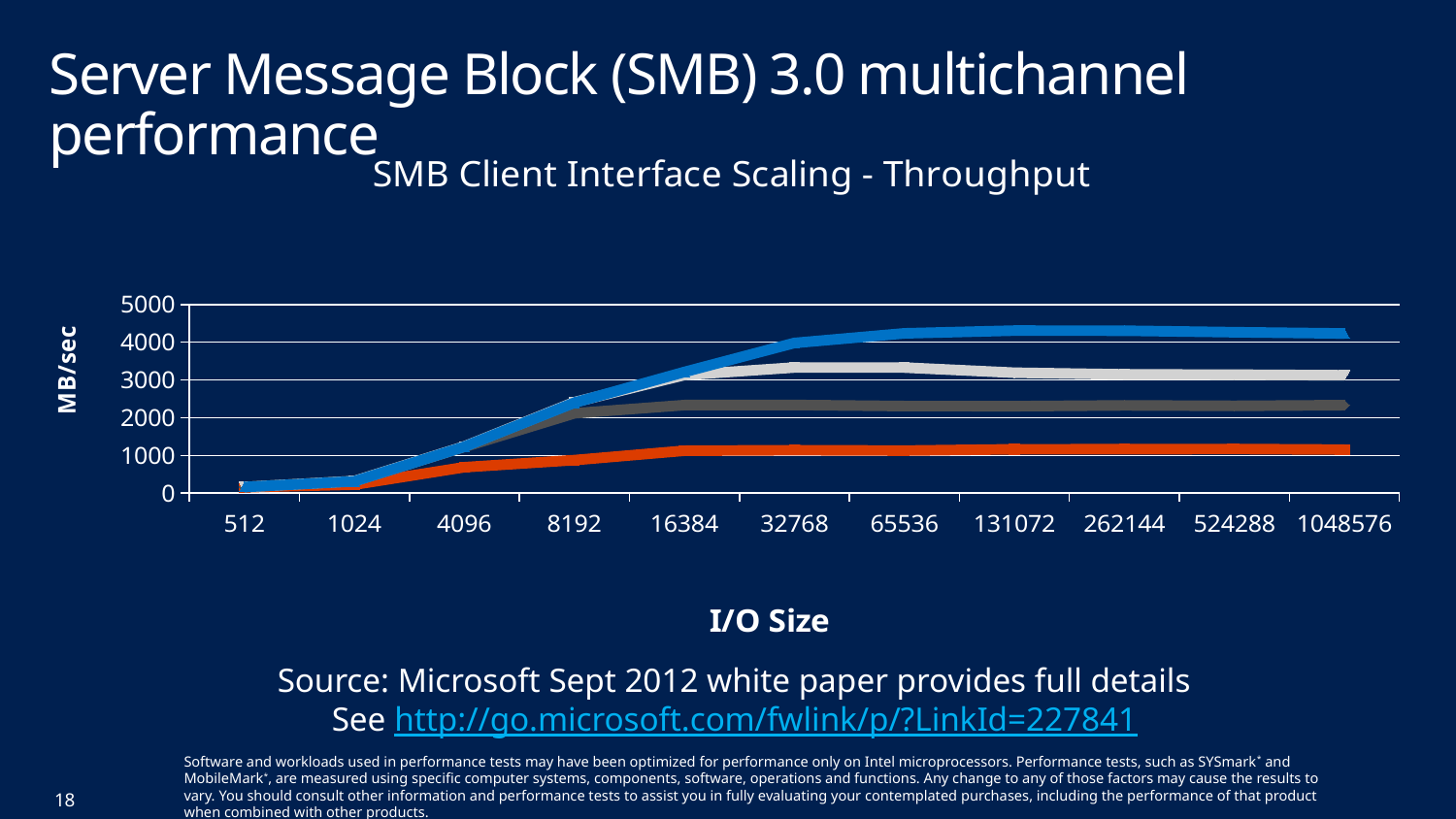
How many I/O size categories are shown on the x axis? 11 Is the value of the orange line at 1048576 greater or less than 2000? less Is the value of the blue line at 1048576 greater or less than 4000? greater Does the blue line rise or fall from 512 to 32768? rise What is the title of the chart? SMB Client Interface Scaling - Throughput How many lines are plotted on the chart? 4 What is the label on the vertical axis of the chart? MB/sec Is the value of the dark gray line at 262144 greater or less than 2000? greater What kind of chart is shown on the slide? line chart Which line has the highest value at 1048576? the blue line At 65536, which is larger: the blue line or the orange line? the blue line